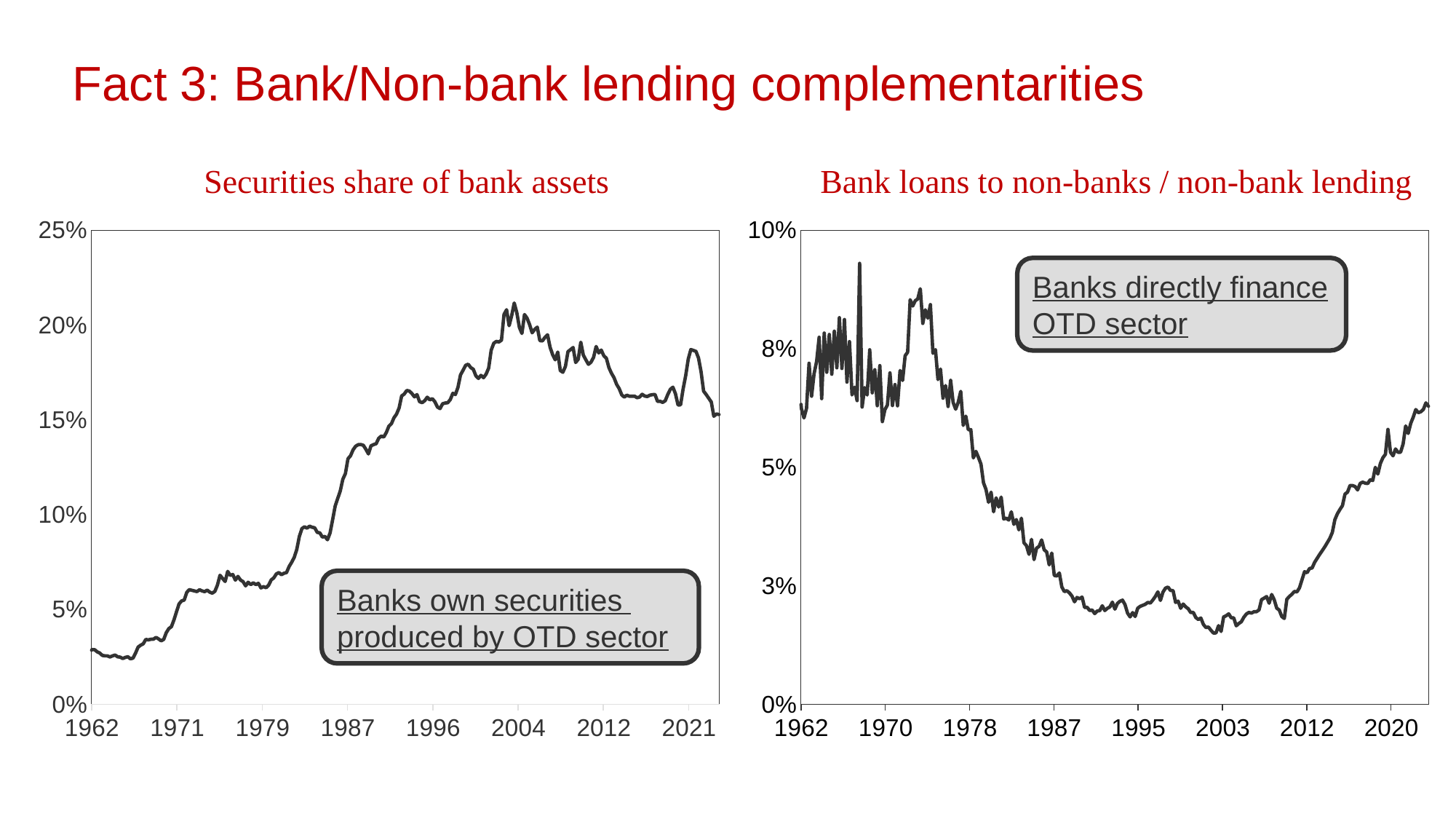
In the 'Securities share of bank assets' chart, is the value in 1987 greater or less than 10%? greater What kind of chart is the 'Bank loans to non-banks / non-bank lending' chart? line chart In the 'Bank loans to non-banks / non-bank lending' chart, does the value generally rise or fall between 2003 and 2020? rise What is the title of the chart on the right side of the slide? Bank loans to non-banks / non-bank lending In the 'Securities share of bank assets' chart, is the value in 1962 greater or less than 5%? less What kind of chart is the 'Securities share of bank assets' chart? line chart What does the annotation box on the 'Securities share of bank assets' chart say? Banks own securities produced by OTD sector In the 'Securities share of bank assets' chart, does the value generally rise or fall between 1962 and 2004? rise In the 'Bank loans to non-banks / non-bank lending' chart, is the value in 1962 greater or less than 5%? greater In the 'Bank loans to non-banks / non-bank lending' chart, does the value generally rise or fall between 1978 and 2003? fall